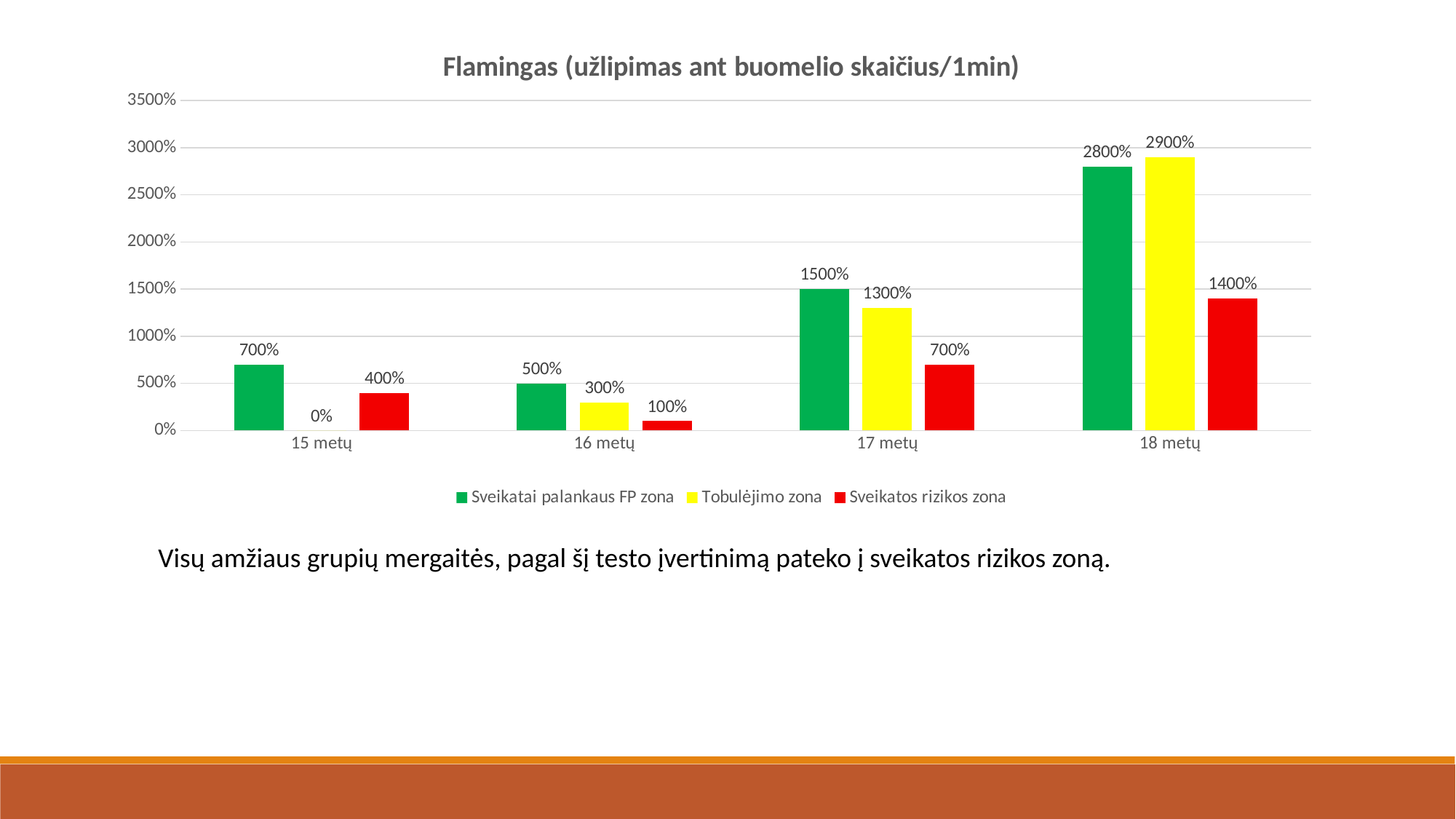
What is the value for Tobulėjimo zona at 16 metų? 300% What is the value for Sveikatos rizikos zona at 18 metų? 1400% How many series does the legend list? 3 Which age group has the lowest value for Sveikatos rizikos zona? 16 metų What kind of chart is shown on the slide? Bar chart What is the difference between the Sveikatai palankaus FP zona and Tobulėjimo zona values at 17 metų? 200% What is the value for Sveikatai palankaus FP zona at 15 metų? 700% Which is larger at 18 metų: Sveikatai palankaus FP zona or Tobulėjimo zona? Tobulėjimo zona Which age group has the highest value for Tobulėjimo zona? 18 metų What is the value for Tobulėjimo zona at 15 metų? 0% What is the title of the chart? Flamingas (užlipimas ant buomelio skaičius/1min) How many age groups are shown on the x axis? 4